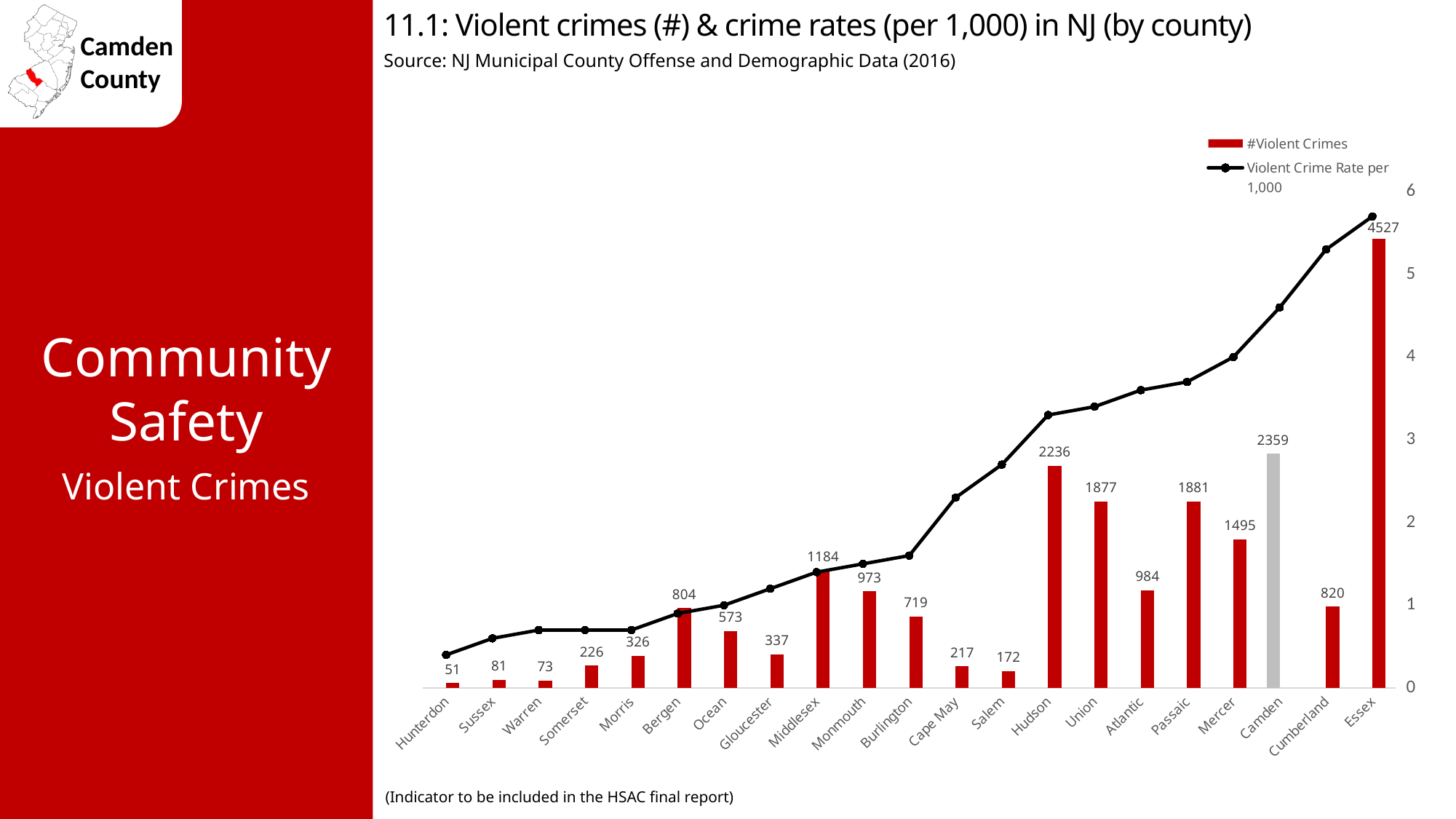
What kind of chart is this? Bar chart with a line overlay Does the violent crime rate per 1,000 line generally rise or fall from Hunterdon to Essex? Rise Is the violent crime rate per 1,000 for Essex greater or less than 5? greater How many counties are shown on the x axis of the chart? 21 Which county has the lowest number of violent crimes? Hunterdon Is the violent crime rate per 1,000 for Hunterdon greater or less than 1? less How many series does the legend list? 2 What is the number of violent crimes shown for Essex? 4527 What is the difference between the number of violent crimes in Camden and in Hudson? 123 Which county has the highest number of violent crimes? Essex Which county has more violent crimes, Mercer or Atlantic? Mercer What is the number of violent crimes shown for Camden? 2359